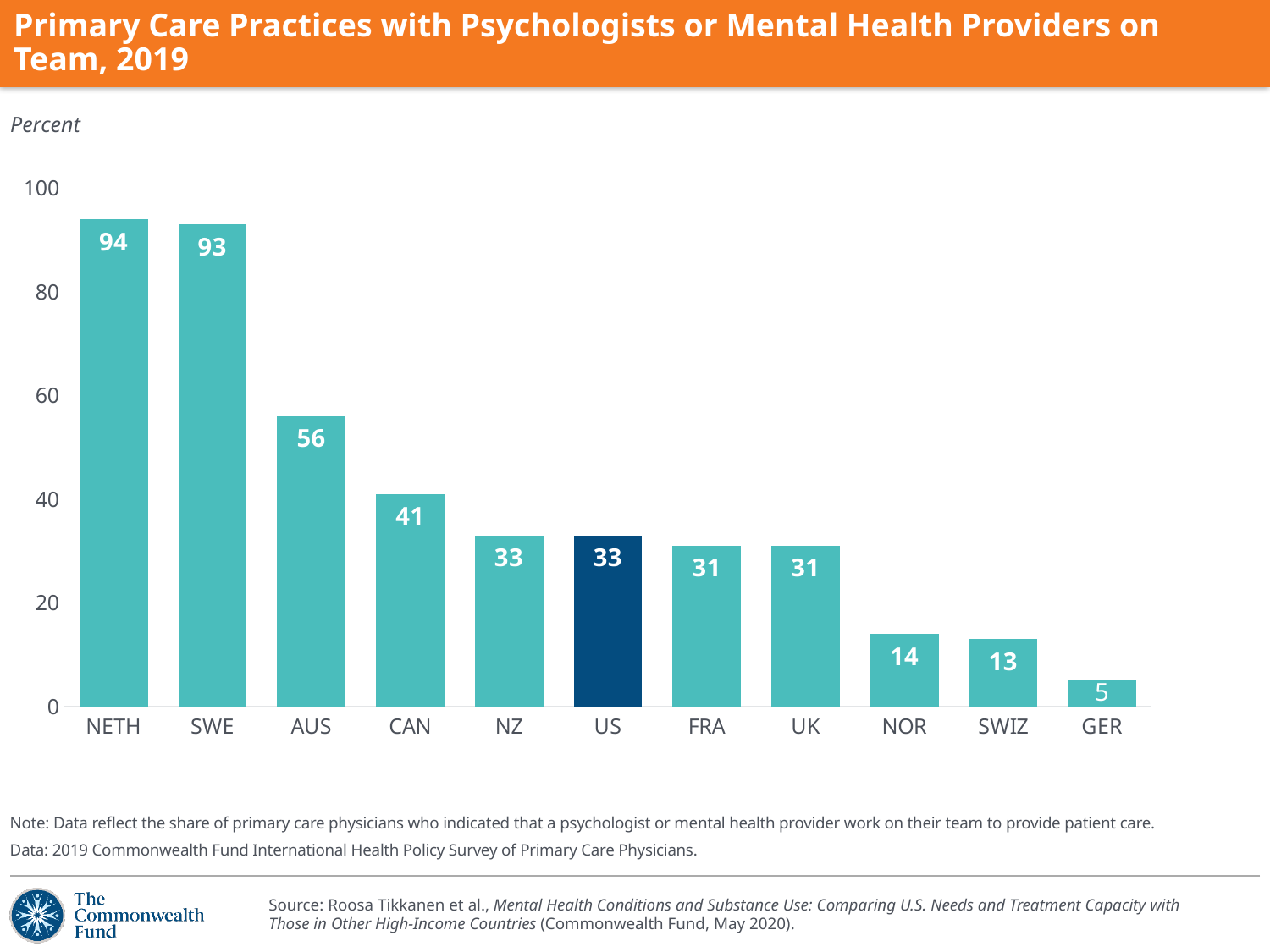
Which bar is shown in a different (dark blue) colour from the others? US Which country has the highest value? NETH Which country has the lowest value? GER Which is larger, the value for SWE or the value for AUS? SWE What is the value for the US? 33 What is the difference between the values for AUS and CAN? 15 What is the difference between the values for NETH and GER? 89 What is the value for NOR? 14 Is the value for CAN greater or less than 40? greater How many countries are shown on the chart? 11 What is the value for AUS? 56 What kind of chart is shown on the slide? bar chart